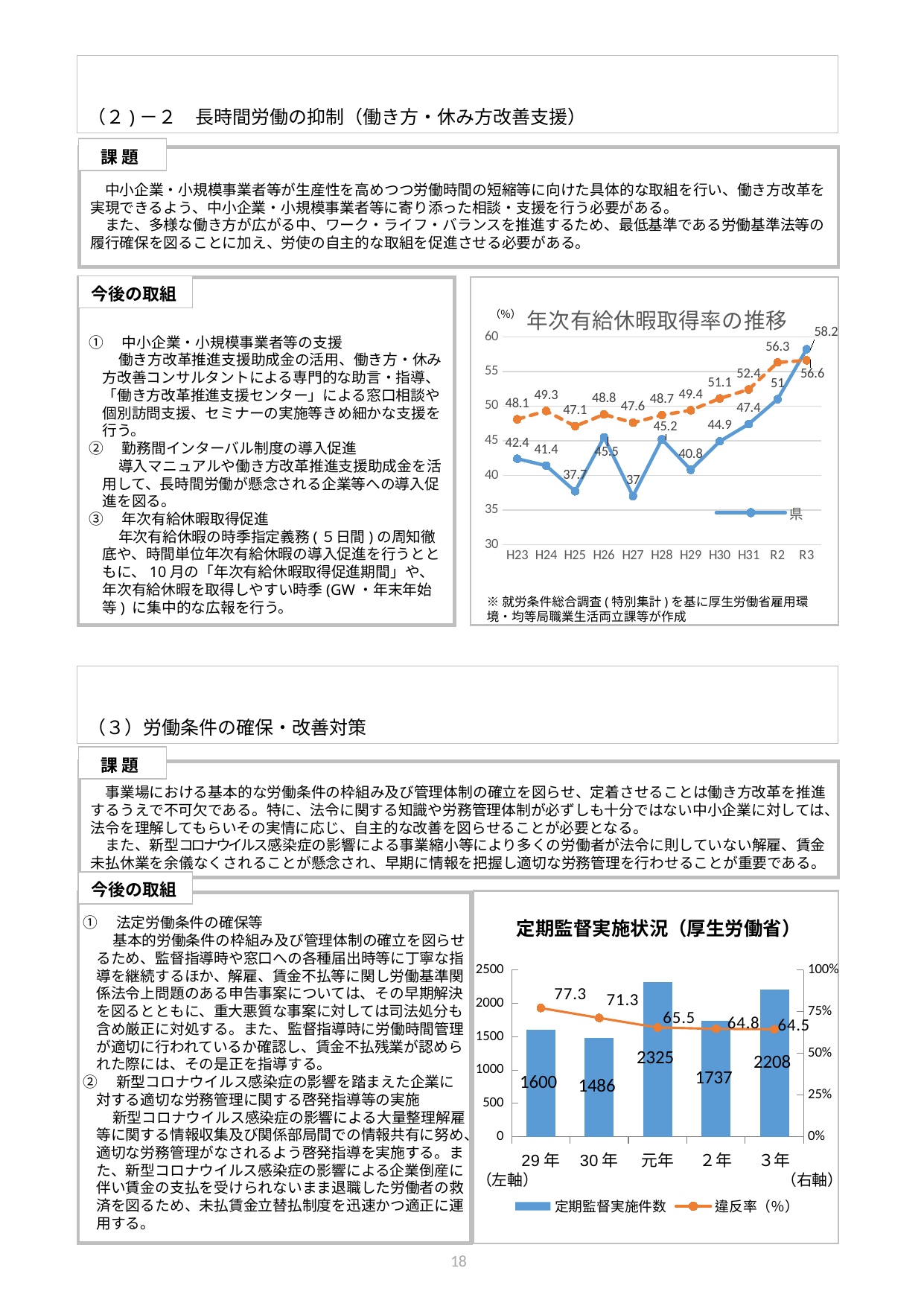
In the chart titled 定期監督実施状況（厚生労働省）, how many series does the legend list? 2 In the chart titled 年次有給休暇取得率の推移, what is the value of the 県 series for H27? 37 In the chart titled 定期監督実施状況（厚生労働省）, what is the 定期監督実施件数 for 元年? 2325 In the chart titled 定期監督実施状況（厚生労働省）, does the 違反率（%） rise or fall from 29年 to 3年? fall In the chart titled 年次有給休暇取得率の推移, in which year is the 県 series lowest? H27 In the chart titled 年次有給休暇取得率の推移, what is the value of the 県 series for R3? 58.2 In the chart titled 定期監督実施状況（厚生労働省）, which year has the lowest 定期監督実施件数? 30年 In the chart titled 年次有給休暇取得率の推移, what is the difference between the 県 values for R3 and R2? 7.2 In the chart titled 年次有給休暇取得率の推移, how many years are shown on the x axis? 11 In the chart titled 定期監督実施状況（厚生労働省）, what is the difference in 定期監督実施件数 between 元年 and 2年? 588 In the chart titled 年次有給休暇取得率の推移, in which year is the 県 series highest? R3 In the chart titled 定期監督実施状況（厚生労働省）, what is the 違反率（%） for 29年? 77.3